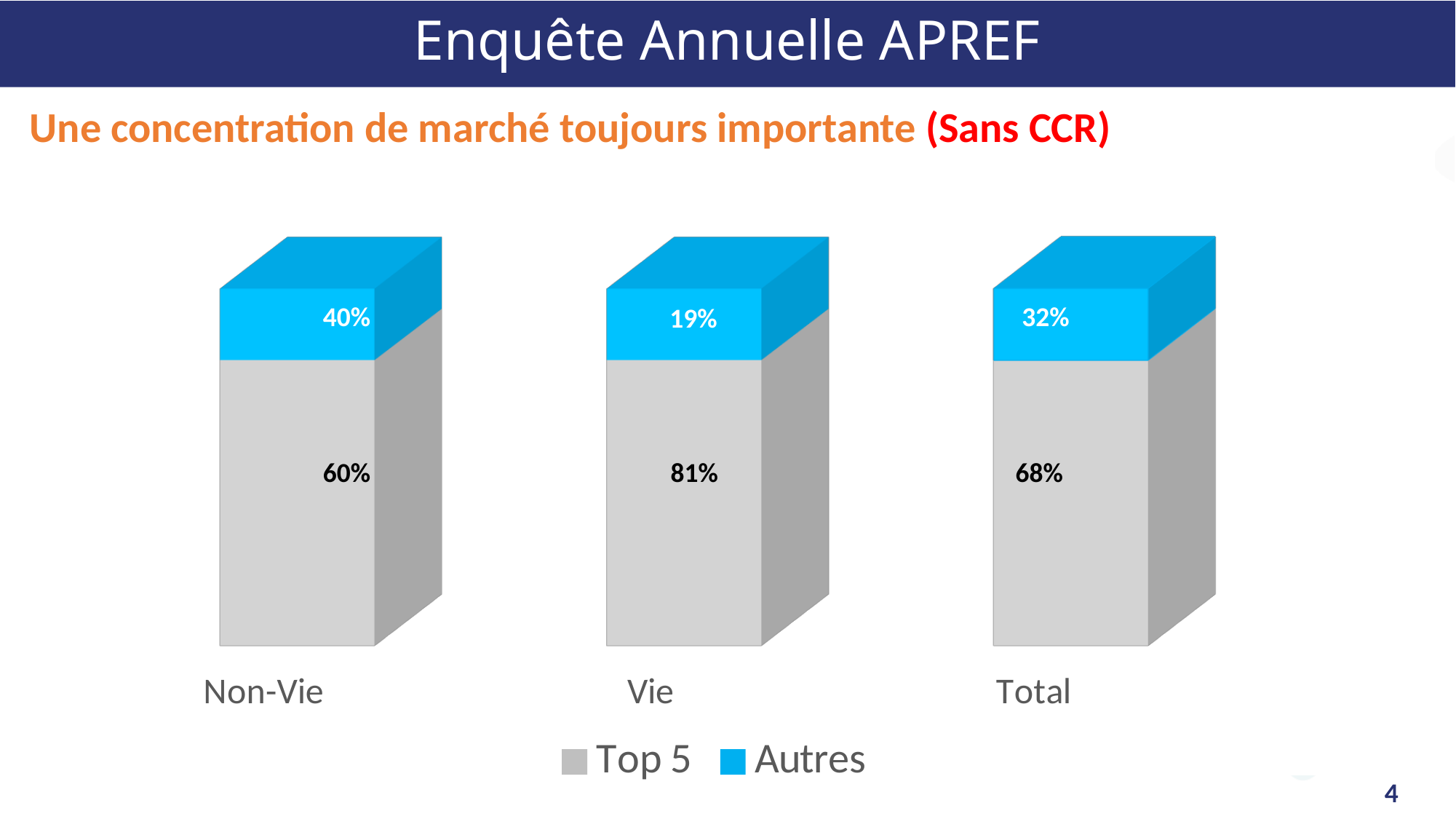
Which is larger, the Autres value for Total or the Autres value for Vie? Total Which category has the highest Top 5 share? Vie What is the difference between the Top 5 value for Vie and the Top 5 value for Non-Vie? 21% How many categories are shown on the x axis? 3 What is the Autres value for Non-Vie? 40% What is the Autres value for Vie? 19% Which category has the lowest Autres share? Vie What is the Top 5 value for Non-Vie? 60% What kind of chart is shown on the slide? Stacked bar chart How many series does the legend list? 2 What is the total of the stacked bar for Total? 100% What is the Top 5 value for Total? 68%